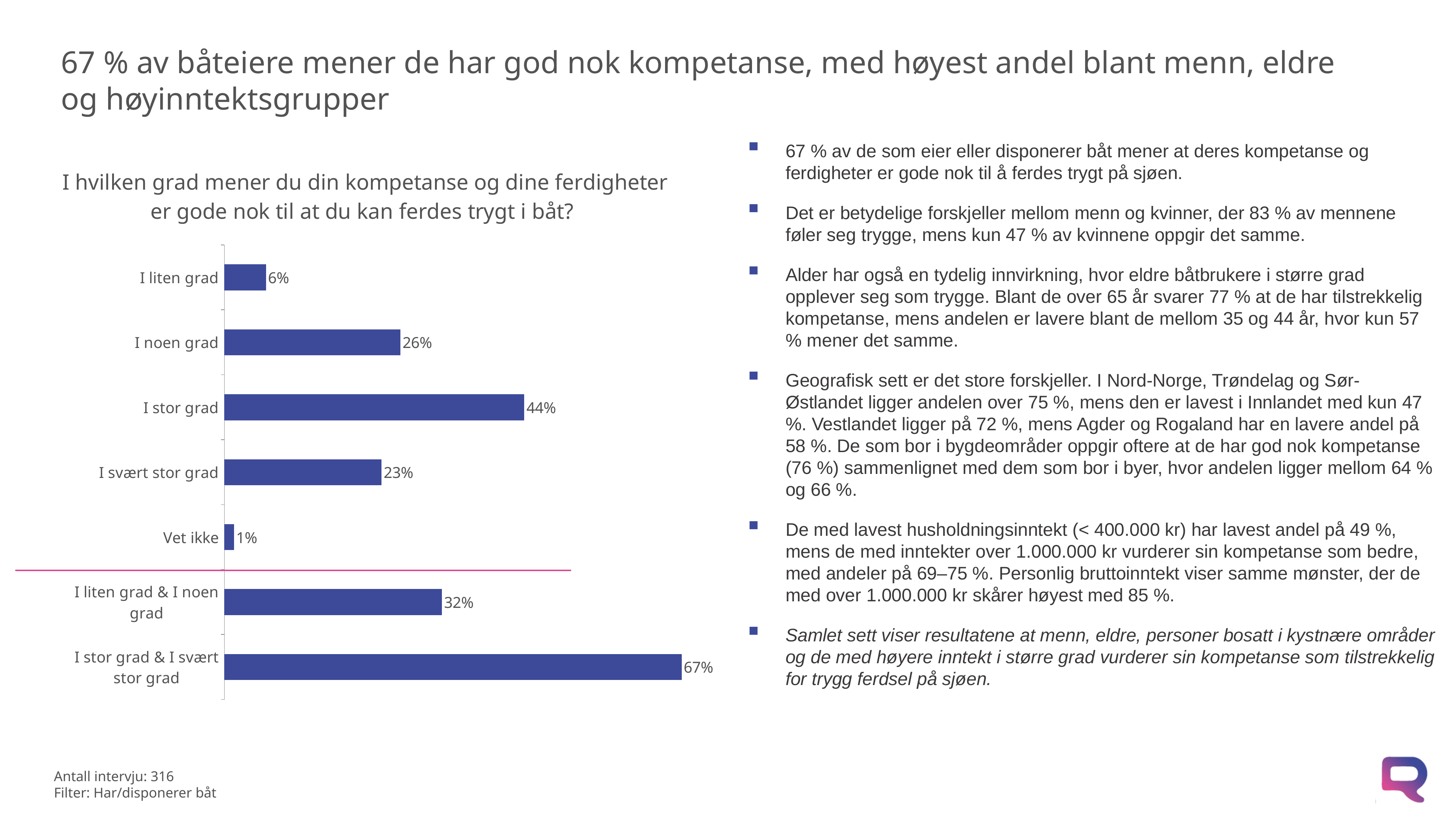
What is the difference between "I stor grad" and "I svært stor grad"? 21 percentage points What is the value for "I stor grad & I svært stor grad"? 67% How many categories are shown in the chart? 7 What is the value for "I stor grad"? 44% What is the difference between "I stor grad & I svært stor grad" and "I liten grad & I noen grad"? 35 percentage points What is the question shown as the chart's title? I hvilken grad mener du din kompetanse og dine ferdigheter er gode nok til at du kan ferdes trygt i båt? What is the value for "Vet ikke"? 1% Which is larger, "I noen grad" or "I svært stor grad"? I noen grad What kind of chart is shown on the slide? Bar chart Which category has the highest value? I stor grad & I svært stor grad Which category has the lowest value? Vet ikke What is the value for "I noen grad"? 26%